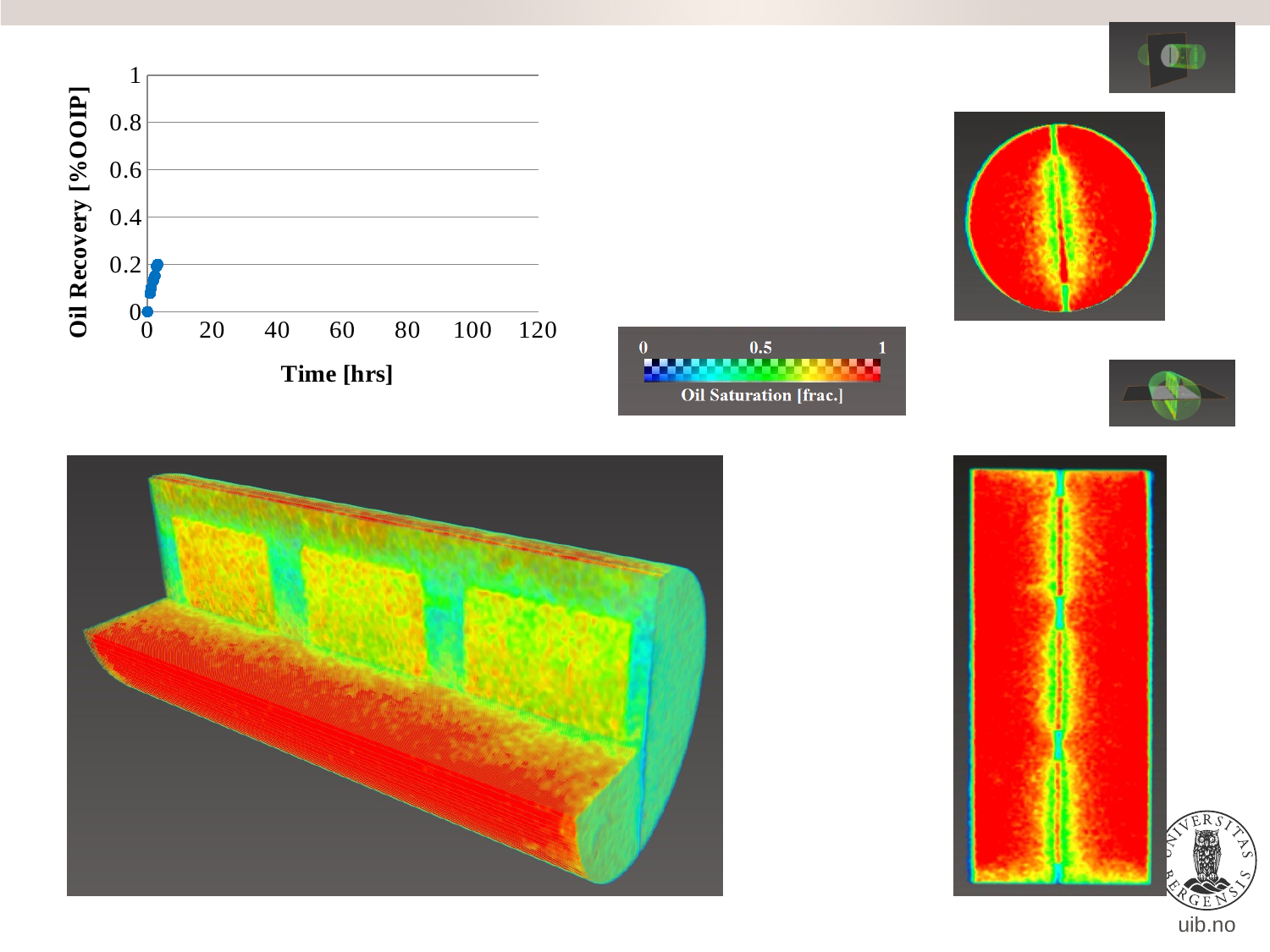
Do the plotted oil recovery values rise or fall as time increases? rise Is the highest plotted oil recovery value greater or less than 0.6? less Is the highest plotted oil recovery value greater or less than 0.4? less Are all the plotted points at times less than or greater than 20 hrs? less What kind of chart is shown on the slide? scatter chart What is the maximum value shown on the y axis of the chart? 1 What is the label of the x axis of the chart? Time [hrs] What is the maximum value shown on the x axis of the chart? 120